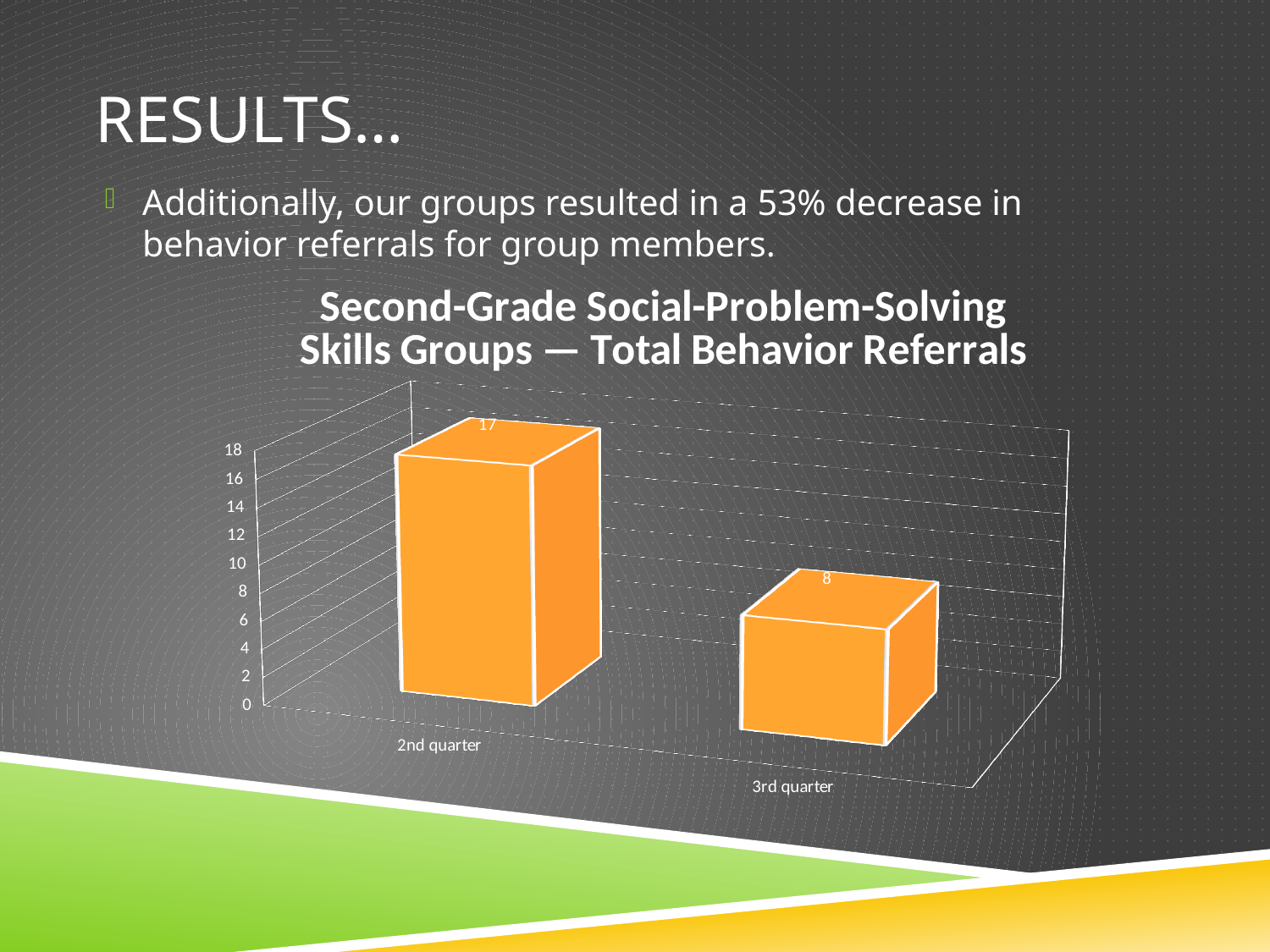
What is the title of the chart? Second-Grade Social-Problem-Solving Skills Groups — Total Behavior Referrals How many categories are shown on the x axis? 2 Is the value for 2nd quarter greater or less than 14? greater Which is larger, the value for 2nd quarter or the value for 3rd quarter? 2nd quarter Is the value for 3rd quarter greater or less than 10? less What is the value for 3rd quarter? 8 Do the values rise or fall from 2nd quarter to 3rd quarter? fall Which quarter has the highest number of behavior referrals? 2nd quarter What is the value for 2nd quarter? 17 Which quarter has the lowest number of behavior referrals? 3rd quarter What is the difference between the 2nd quarter and 3rd quarter values? 9 What kind of chart is shown on the slide? bar chart